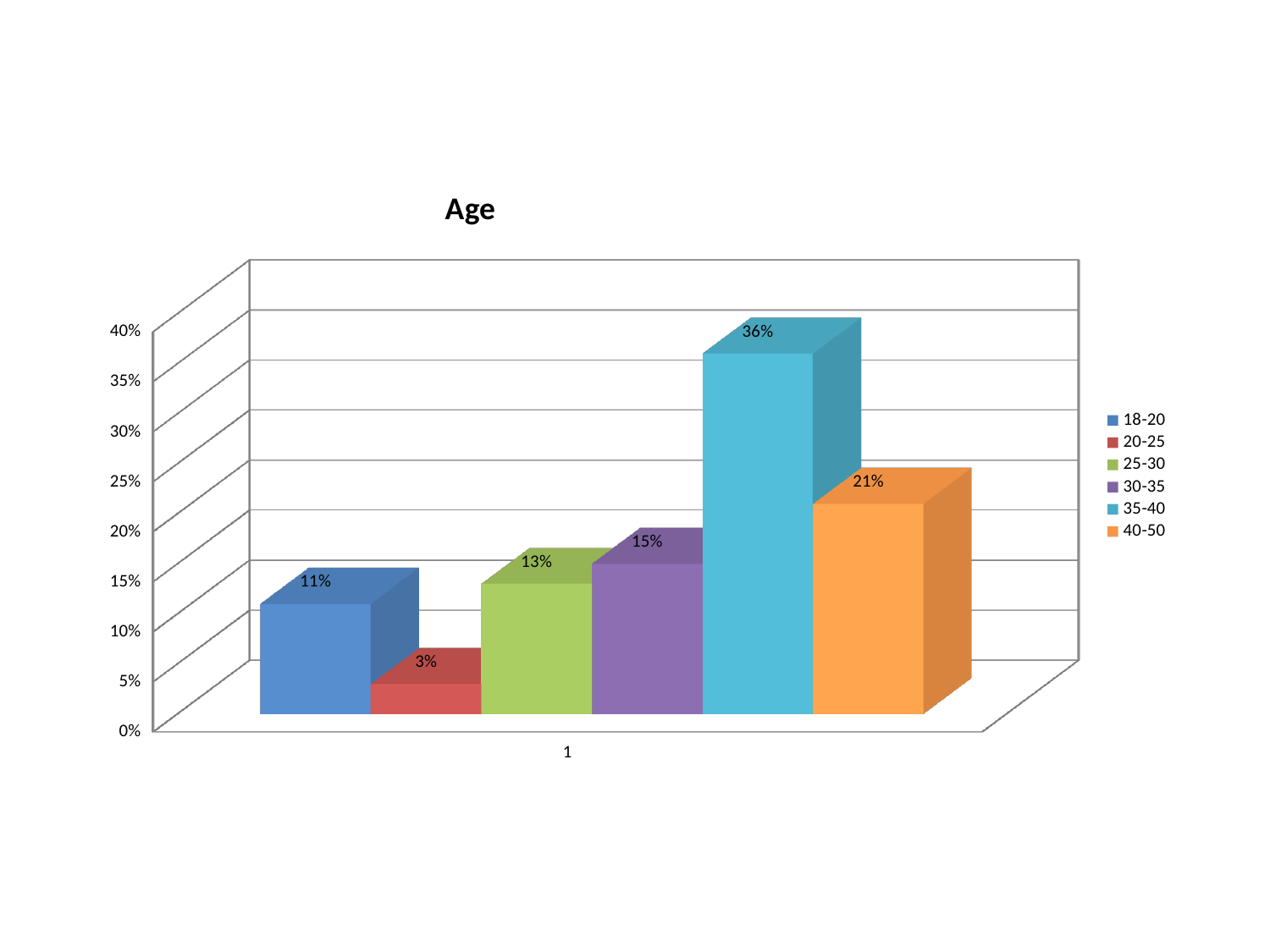
What is the difference between the values for the 30-35 and 25-30 age groups? 2% How many series does the legend list? 6 Which age group has the lowest value? 20-25 What is the title of the chart? Age Which age group has the highest value? 35-40 What kind of chart is shown on the slide? Bar chart What is the difference between the values for the 35-40 and 40-50 age groups? 15% What is the value for the 20-25 age group? 3% Which is larger, the value for 18-20 or the value for 25-30? 25-30 What is the value for the 35-40 age group? 36% What is the value for the 18-20 age group? 11% What is the value for the 40-50 age group? 21%